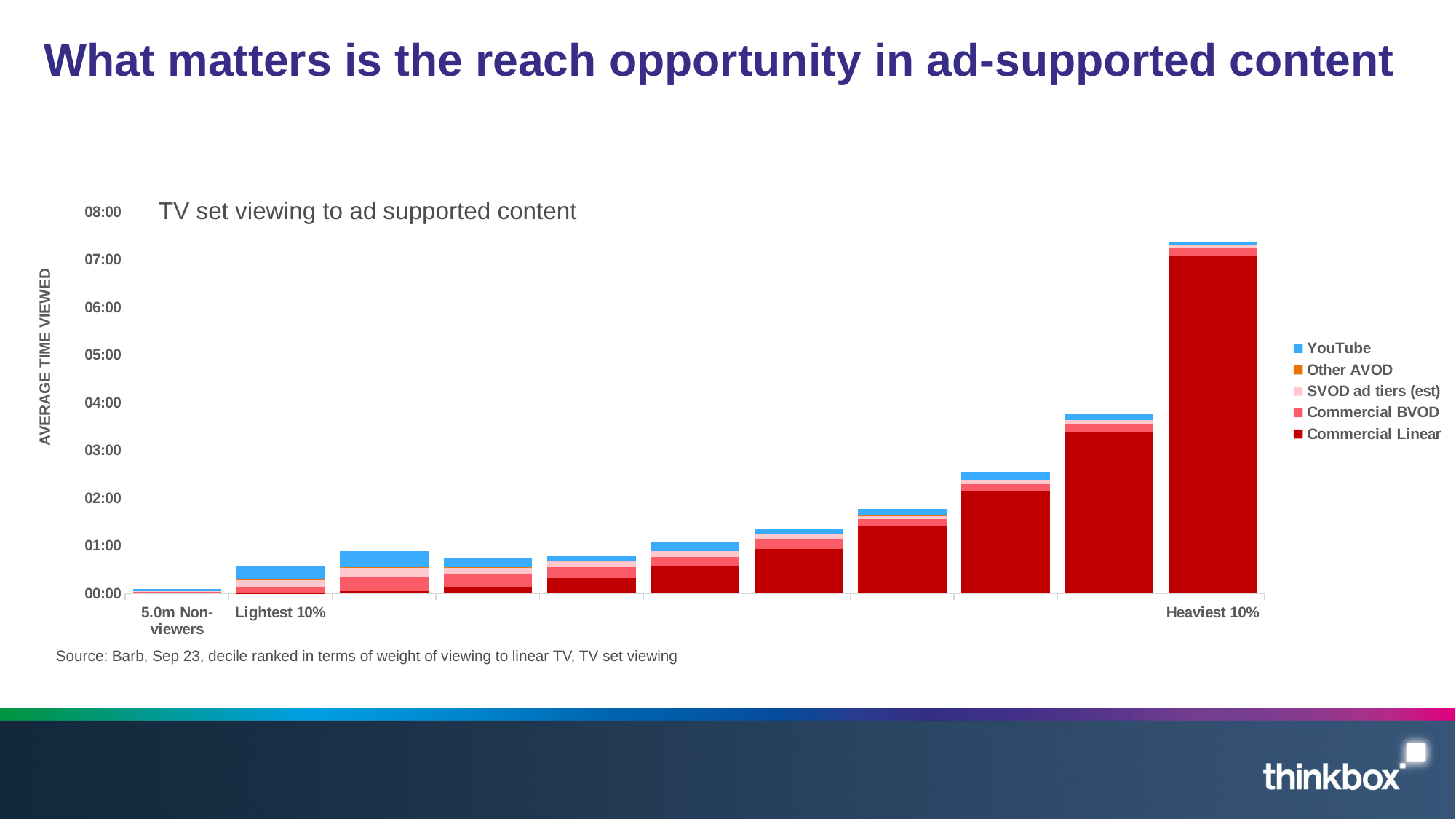
Do the stacked bar totals generally rise or fall from left to right across the x axis? rise What kind of chart is shown on the slide? Stacked bar chart How many bars are plotted in the chart? 11 What is the title of the chart? TV set viewing to ad supported content Which is larger, the stacked bar for Heaviest 10% or the stacked bar for Lightest 10%? Heaviest 10% Is the total stacked value for Lightest 10% greater or less than 01:00? less Which series makes up the largest part of the Heaviest 10% bar? Commercial Linear Which category has the shortest stacked bar? 5.0m Non-viewers Which category has the tallest stacked bar? Heaviest 10% What is the label on the vertical axis? AVERAGE TIME VIEWED How many series does the legend list? 5 Is the total stacked value for Heaviest 10% greater or less than 07:00? greater